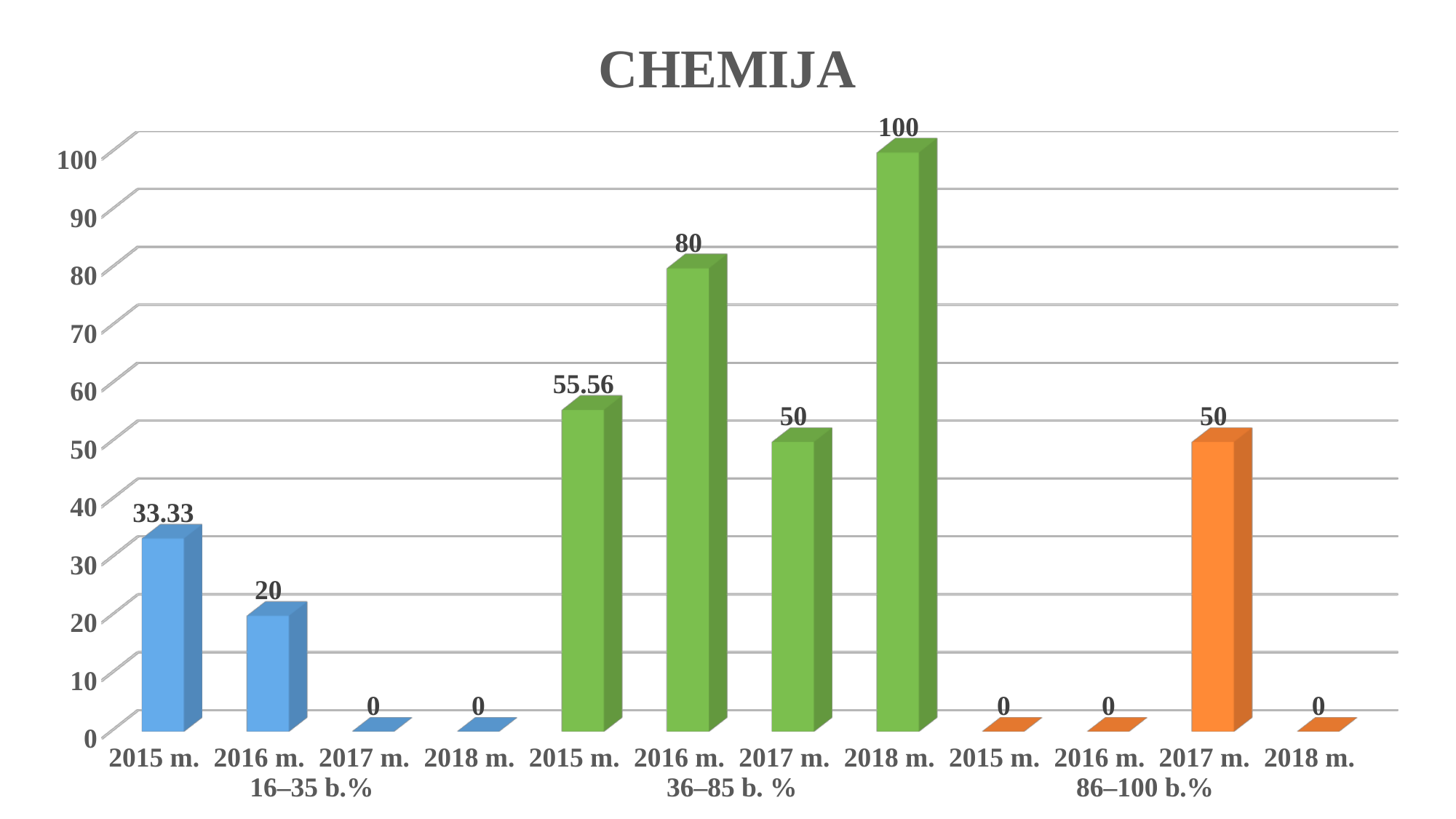
Which bar has the highest value on the chart? 2018 m. (36–85 b. %) Which is larger: the 2015 m. value in the 16–35 b.% group or the 2015 m. value in the 36–85 b. % group? 2015 m. in the 36–85 b. % group What is the difference between the 2015 m. and 2016 m. values in the 16–35 b.% group? 13.33 What kind of chart is shown on the slide? Bar chart What is the title of the chart? CHEMIJA What is the difference between the 2016 m. and 2015 m. values in the 36–85 b. % group? 24.44 What is the value for 2016 m. in the 36–85 b. % group? 80 What is the value for 2018 m. in the 36–85 b. % group? 100 What is the value for 2015 m. in the 16–35 b.% group? 33.33 What is the value for 2017 m. in the 86–100 b.% group? 50 How many bars have a value of 0? 5 How many bars are plotted on the chart? 12